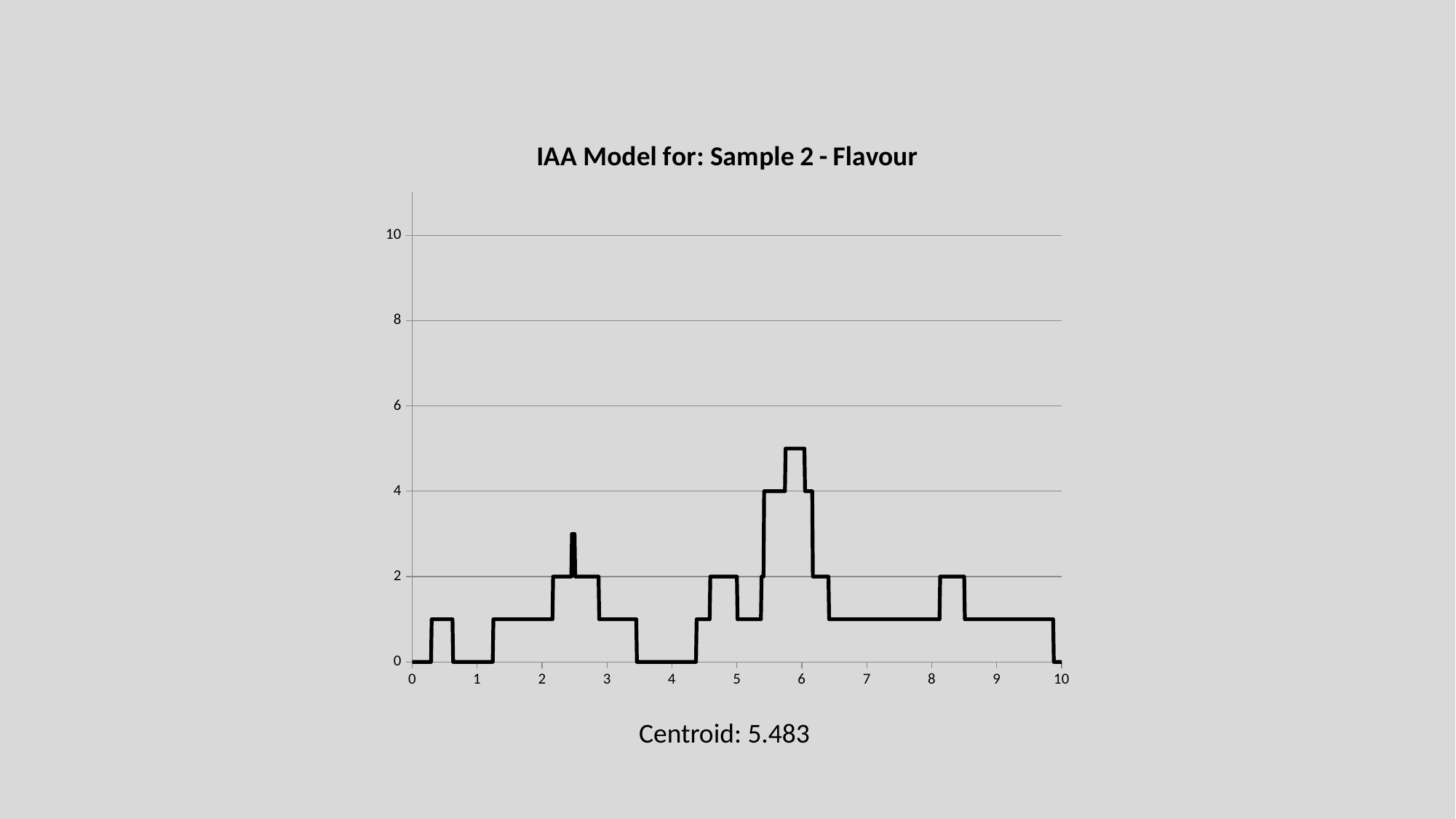
Is the highest value reached by the line greater or less than 4? greater Is the value of the line at x = 9 greater or less than 2? less What is the value of the line at x = 4? 0 What value does the line hold between x = 8.2 and x = 8.5? 2 What is the value of the line at x = 5.5? 4 What is the title of the chart? IAA Model for: Sample 2 - Flavour What kind of chart is shown on the slide? line chart Between which two x-axis ticks does the line reach its highest value? 5 and 6 What centroid value is printed below the chart? 5.483 Which is larger, the value of the line at x = 5.5 or at x = 3? x = 5.5 Is the value of the line at x = 7 greater or less than 2? less Which is larger, the value of the line at x = 7 or at x = 4? x = 7